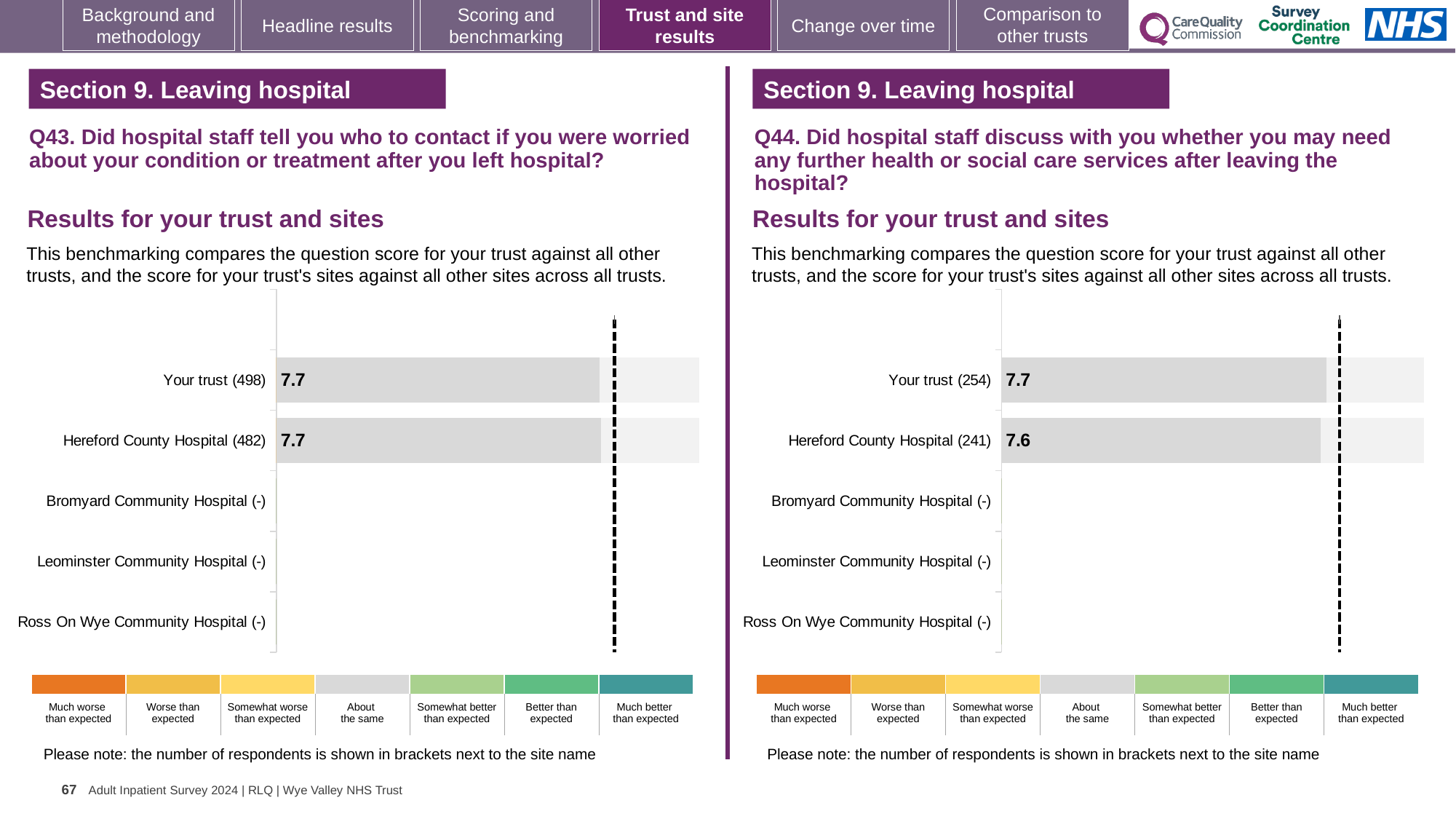
On the Q44 chart (right), which has the higher score, Your trust (254) or Hereford County Hospital (241)? Your trust (254) What kind of chart is used on the Q43 chart (left)? Bar chart On the Q44 chart (right), how many categories have a plotted bar with a score? 2 On the Q43 chart (left), what is the score for Your trust (498)? 7.7 On the Q44 chart (right), what is the score for Your trust (254)? 7.7 On the Q43 chart (left), how many respondents are shown in brackets for Hereford County Hospital? 482 On the Q44 chart (right), what is the difference between the score for Your trust (254) and Hereford County Hospital (241)? 0.1 How many categories does the colour legend below each chart list? 7 On the Q44 chart (right), how many respondents are shown in brackets for Your trust? 254 On the Q43 chart (left), what is the score for Hereford County Hospital (482)? 7.7 On the Q44 chart (right), what is the score for Hereford County Hospital (241)? 7.6 On the Q43 chart (left), how many site or trust categories are listed on the vertical axis? 5